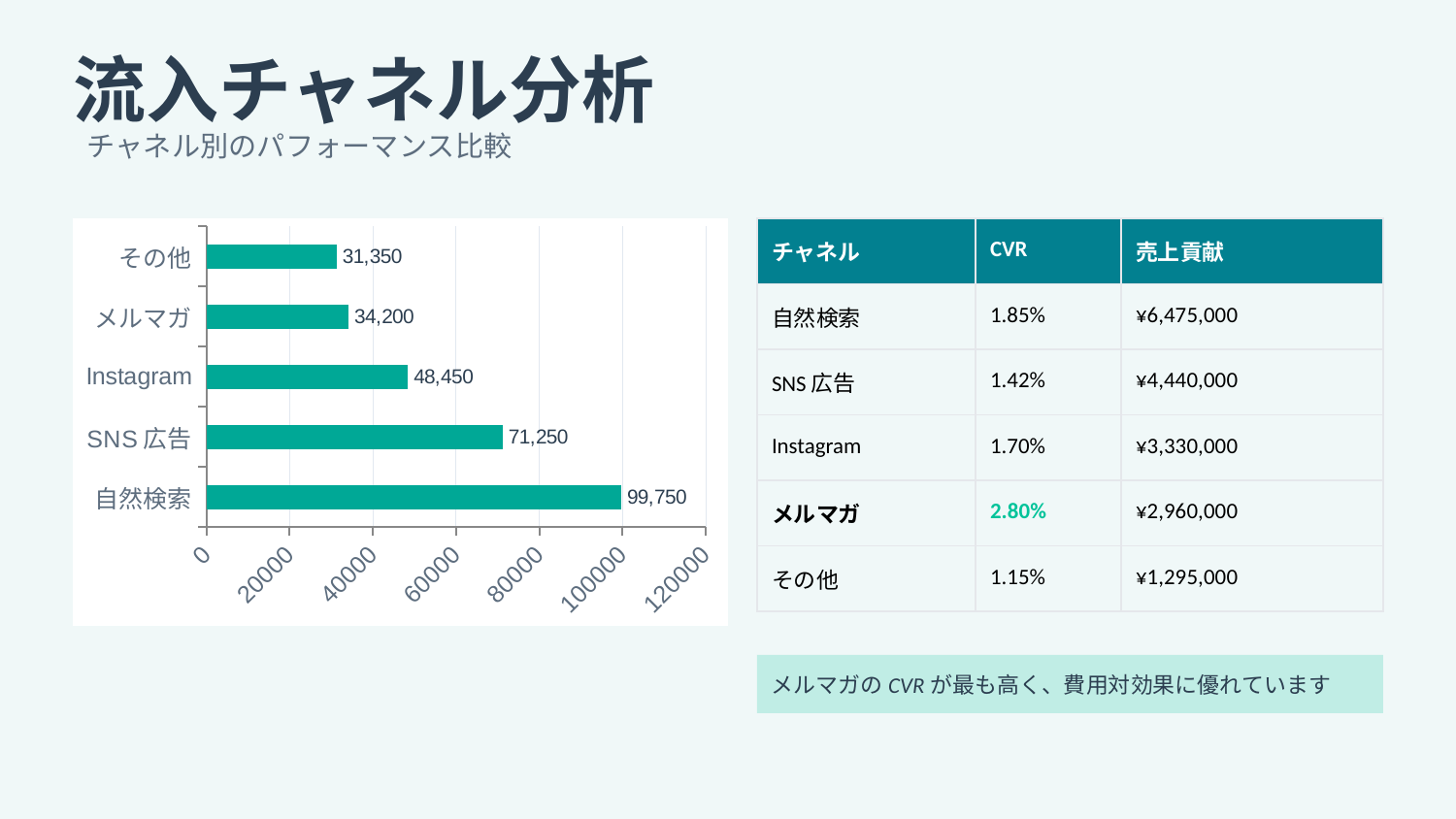
What is the value for メルマガ in the bar chart? 34,200 What is the value for Instagram in the bar chart? 48,450 What kind of chart is shown on the slide? bar chart What is the maximum value shown on the x axis of the bar chart? 120000 What is the difference between the values for 自然検索 and SNS 広告 in the bar chart? 28,500 Which category has the highest value in the bar chart? 自然検索 Which is larger in the bar chart, SNS 広告 or Instagram? SNS 広告 Which category has the lowest value in the bar chart? その他 Is the value for SNS 広告 in the bar chart greater or less than 60000? greater What is the difference between the values for メルマガ and その他 in the bar chart? 2,850 How many categories are shown in the bar chart? 5 What is the value for 自然検索 in the bar chart? 99,750